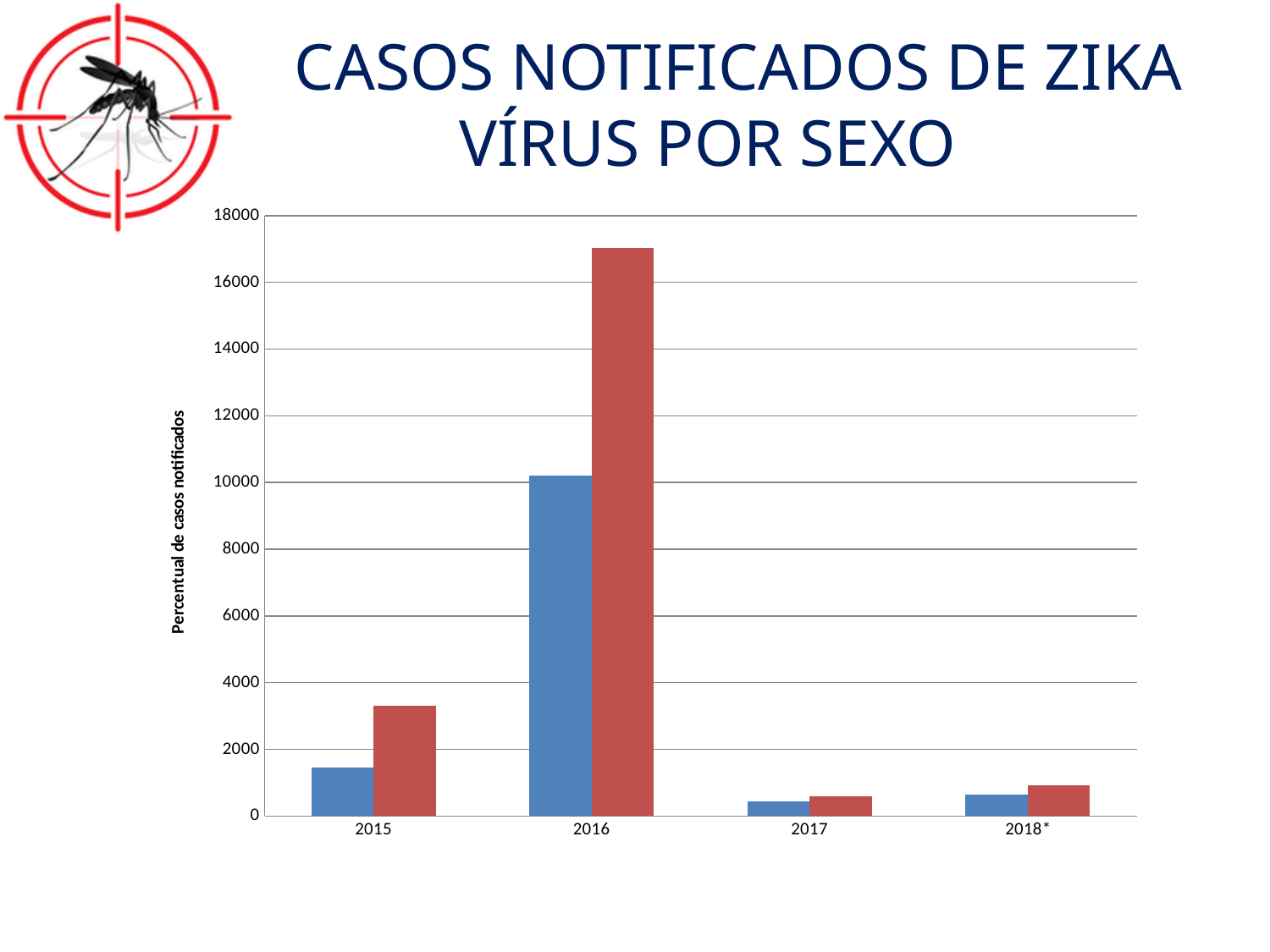
What is the title of the vertical axis? Percentual de casos notificados Do the values rise or fall from 2016 to 2017? fall Is the value of the red bar for 2015 greater or less than 4000? less In 2015, which bar is taller, the blue one or the red one? the red one What kind of chart is shown on the slide? bar chart How many year categories are shown on the x axis? 4 Is the value of the red bar for 2018* greater or less than 2000? less Is the value of the blue bar for 2015 greater or less than 2000? less In which year is the red bar the highest? 2016 In which year is the blue bar the lowest? 2017